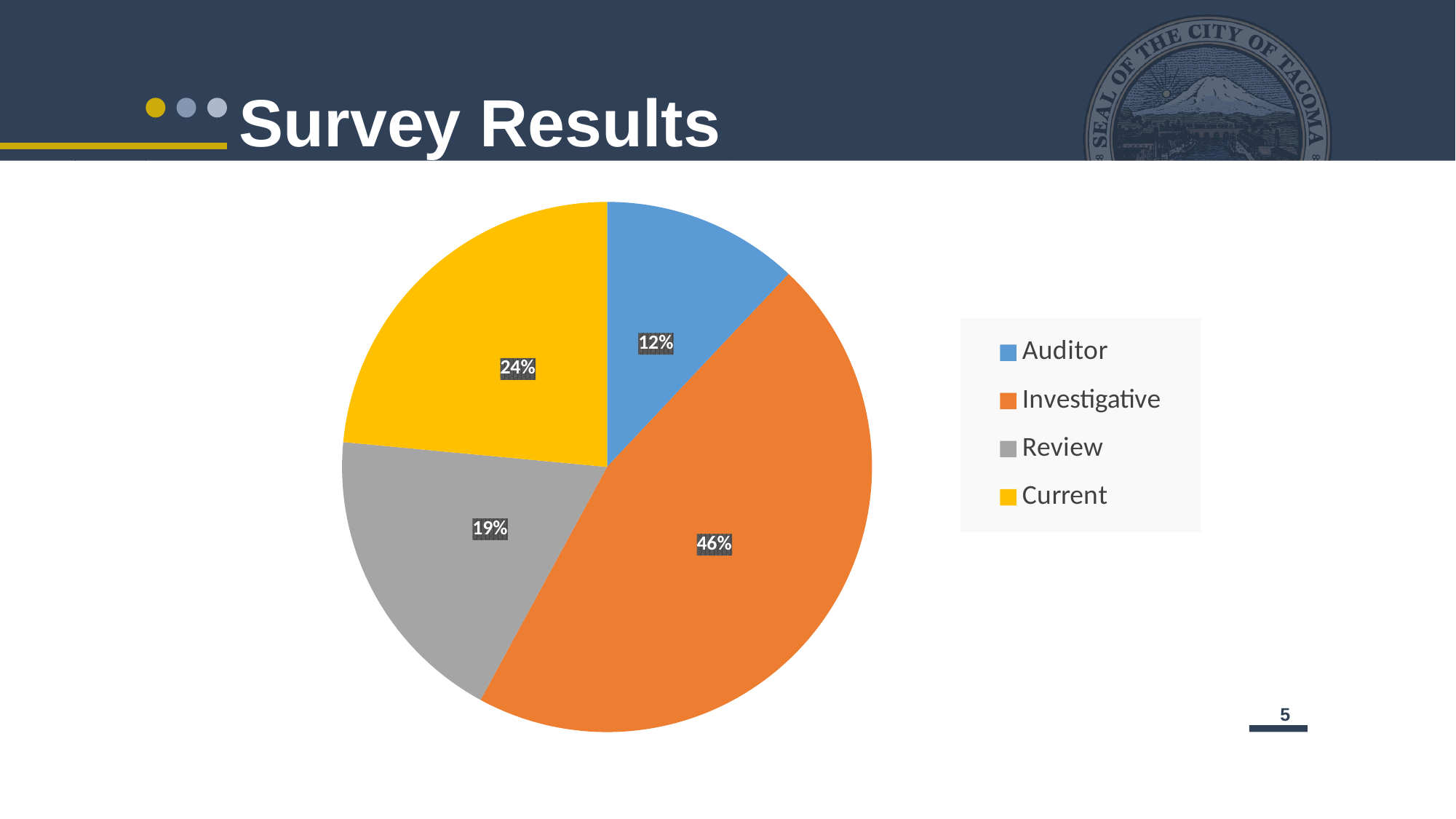
Which category has the largest share of the pie? Investigative What is the difference in percentage points between the Investigative and Current slices? 22 What is the title of the slide containing the chart? Survey Results Which is larger, the Review slice or the Current slice? Current What colour is the Review slice in the pie chart? gray What kind of chart is shown on the slide? pie chart What percentage does the Auditor slice show? 12% Which category has the smallest share of the pie? Auditor What percentage does the Investigative slice show? 46% What percentage does the Review slice show? 19% How many categories does the pie chart have? 4 What percentage does the Current slice show? 24%